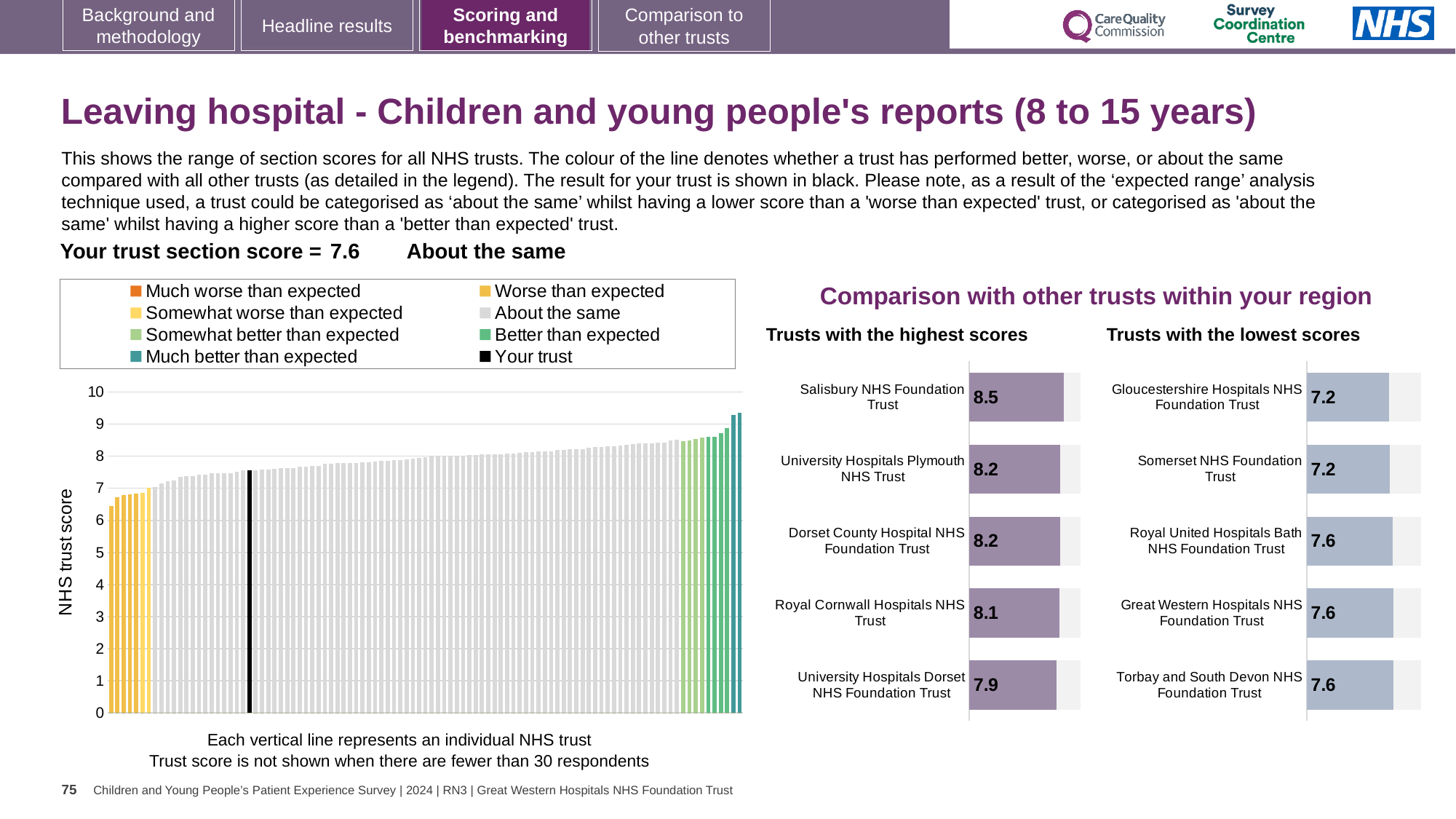
Which is larger: the score for Royal Cornwall Hospitals NHS Trust in the 'highest scores' chart or the score for Great Western Hospitals NHS Foundation Trust in the 'lowest scores' chart? Royal Cornwall Hospitals NHS Trust In the 'Trusts with the highest scores' chart, what is the score for Salisbury NHS Foundation Trust? 8.5 In the 'Trusts with the highest scores' chart, what is the difference between the scores of Salisbury NHS Foundation Trust and University Hospitals Dorset NHS Foundation Trust? 0.6 In the 'Trusts with the lowest scores' chart, what is the score for Gloucestershire Hospitals NHS Foundation Trust? 7.2 How many trusts are shown in the 'Trusts with the lowest scores' chart? 5 In the large chart on the left, do the trust scores rise or fall from left to right along the x axis? rise In the 'Trusts with the lowest scores' chart, what is the difference between the scores of Royal United Hospitals Bath NHS Foundation Trust and Somerset NHS Foundation Trust? 0.4 In the large chart on the left showing the range of section scores, is the value for the rightmost (highest) trust greater or less than 9? greater In the 'Trusts with the highest scores' chart, which trust has the lowest score? University Hospitals Dorset NHS Foundation Trust In the 'Trusts with the highest scores' chart, what is the score for University Hospitals Dorset NHS Foundation Trust? 7.9 In the 'Trusts with the highest scores' chart, which trust has the highest score? Salisbury NHS Foundation Trust In the 'Trusts with the lowest scores' chart, what is the score for Torbay and South Devon NHS Foundation Trust? 7.6